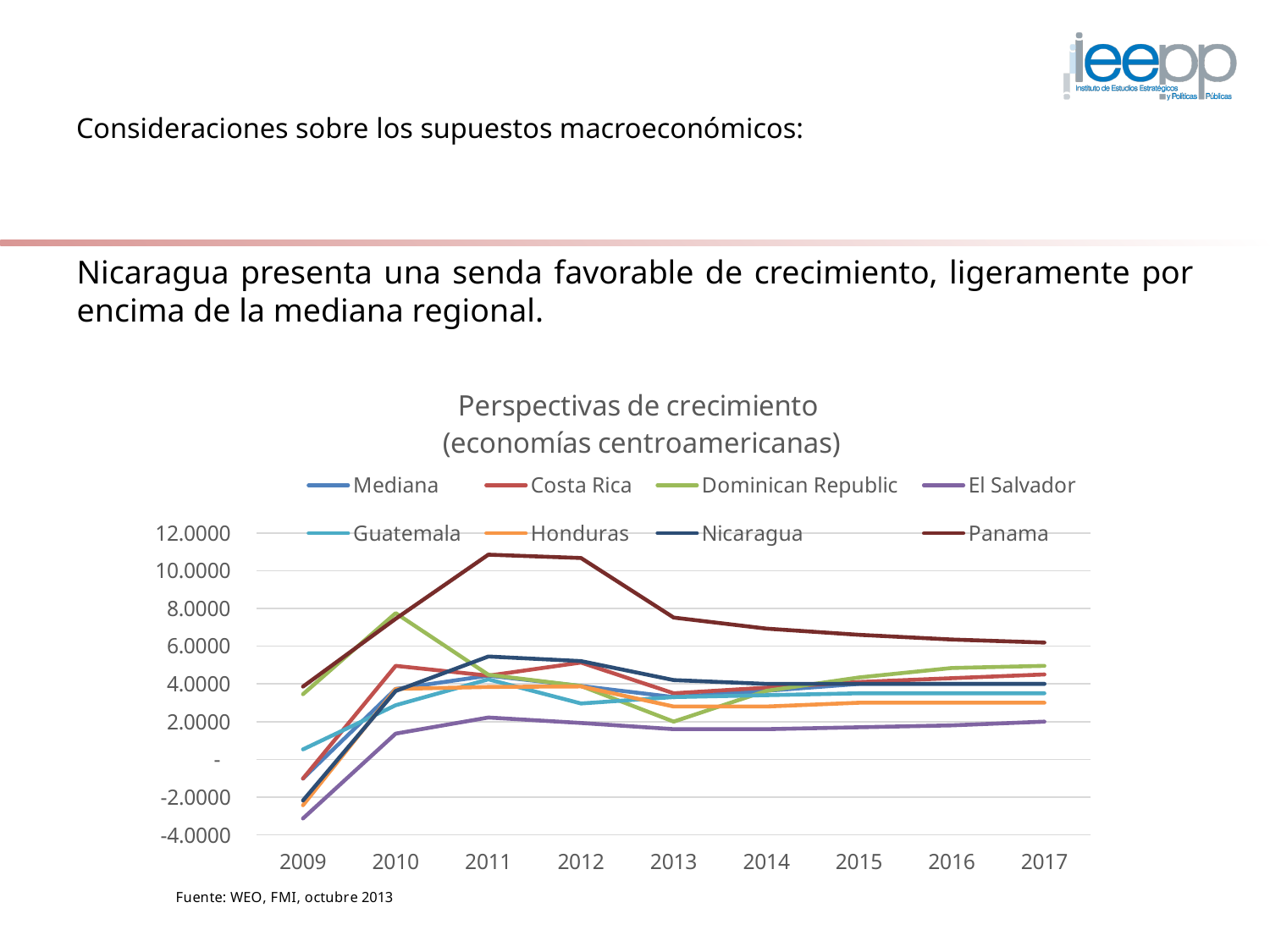
Which country has the highest value in 2009? Panama Is the value for Dominican Republic in 2010 greater or less than 6.0000? greater Which country has the highest value in 2011? Panama How many years are shown on the x axis? 9 Does the value for Panama rise or fall from 2011 to 2017? fall What kind of chart is shown on the slide? line chart Which country has the lowest value in 2017? El Salvador Is the value for El Salvador in 2013 greater or less than 2.0000? less Which is larger in 2013, the value for Panama or the value for Costa Rica? Panama What is the title of the chart? Perspectivas de crecimiento (economías centroamericanas) Is the value for Panama in 2011 greater or less than 10.0000? greater How many series does the legend list? 8